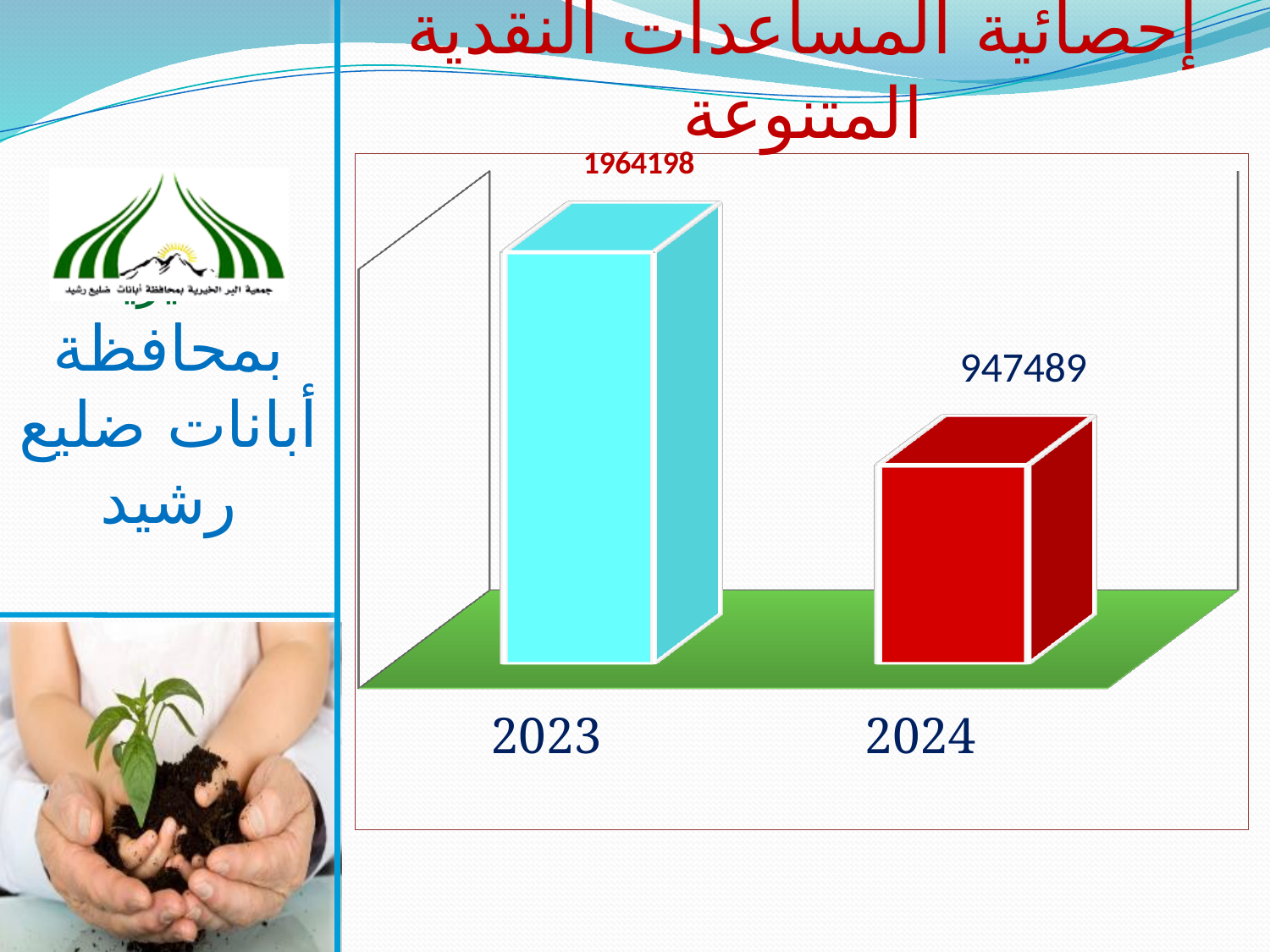
What kind of chart is shown on the slide? bar chart What is the value for 2023? 1964198 What colour is the bar for 2024? red What is the value for 2024? 947489 Which year has the highest value? 2023 Which year has the lowest value? 2024 Do the values rise or fall from 2023 to 2024? fall What colour is the bar for 2023? light blue What is the difference between the values for 2023 and 2024? 1016709 What is the combined total of the values for 2023 and 2024? 2911687 Which is larger, the value for 2023 or the value for 2024? 2023 How many categories are shown on the x axis? 2